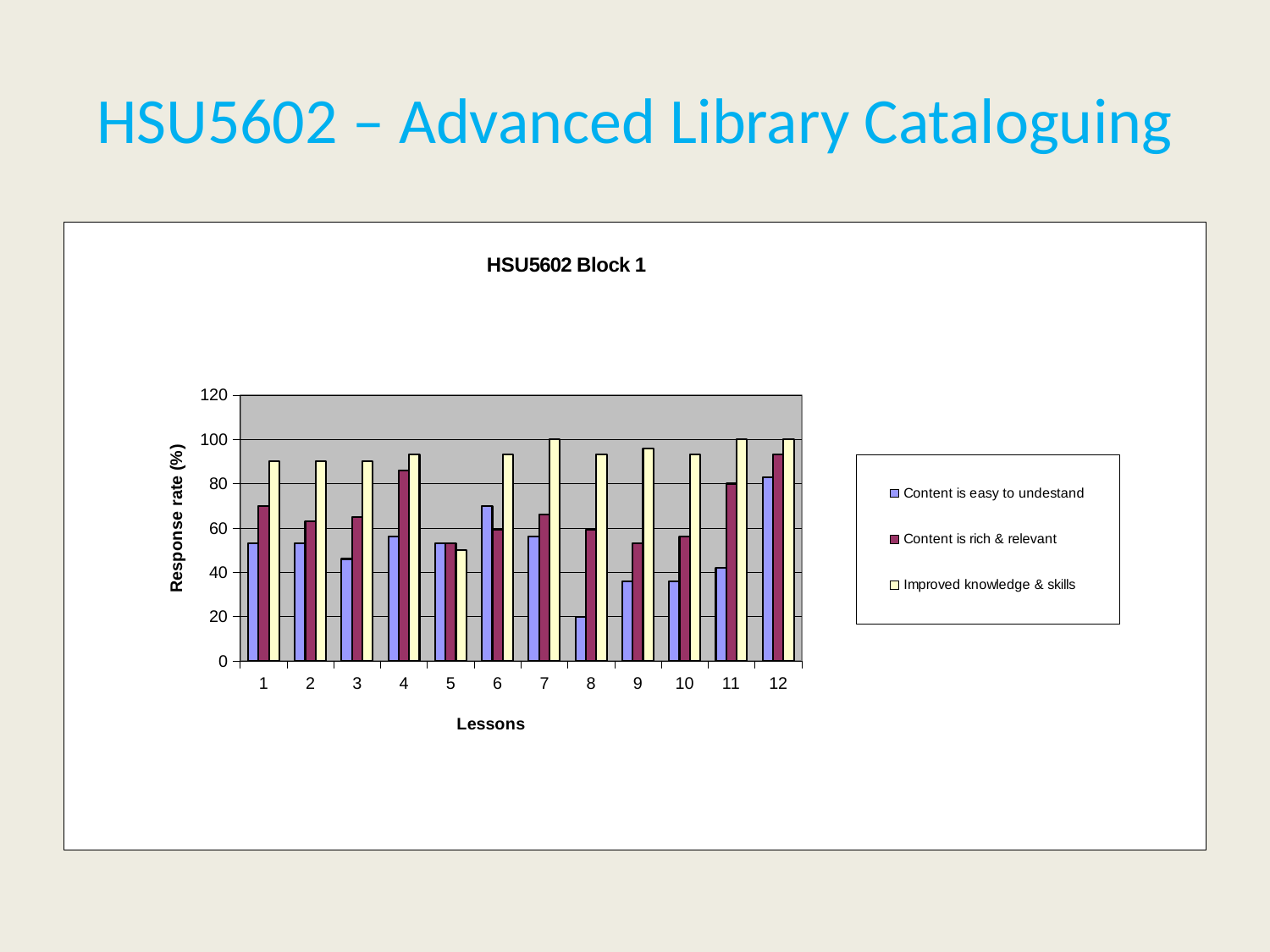
What kind of chart is shown on the slide? Bar chart Is the value for 'Content is rich & relevant' at lesson 4 greater or less than 80? greater What is the label of the vertical axis? Response rate (%) How many series does the legend list? 3 For which lesson is the value for 'Improved knowledge & skills' lowest? 5 For which lesson is the value for 'Content is easy to undestand' highest? 12 How many lessons are shown on the x axis? 12 What is the title of the chart? HSU5602 Block 1 For which lesson is the value for 'Content is easy to undestand' lowest? 8 At lesson 6, which is larger: 'Content is easy to undestand' or 'Content is rich & relevant'? Content is easy to undestand Is the value for 'Content is easy to undestand' at lesson 8 greater or less than 40? less Is the value for 'Improved knowledge & skills' at lesson 5 greater or less than 60? less